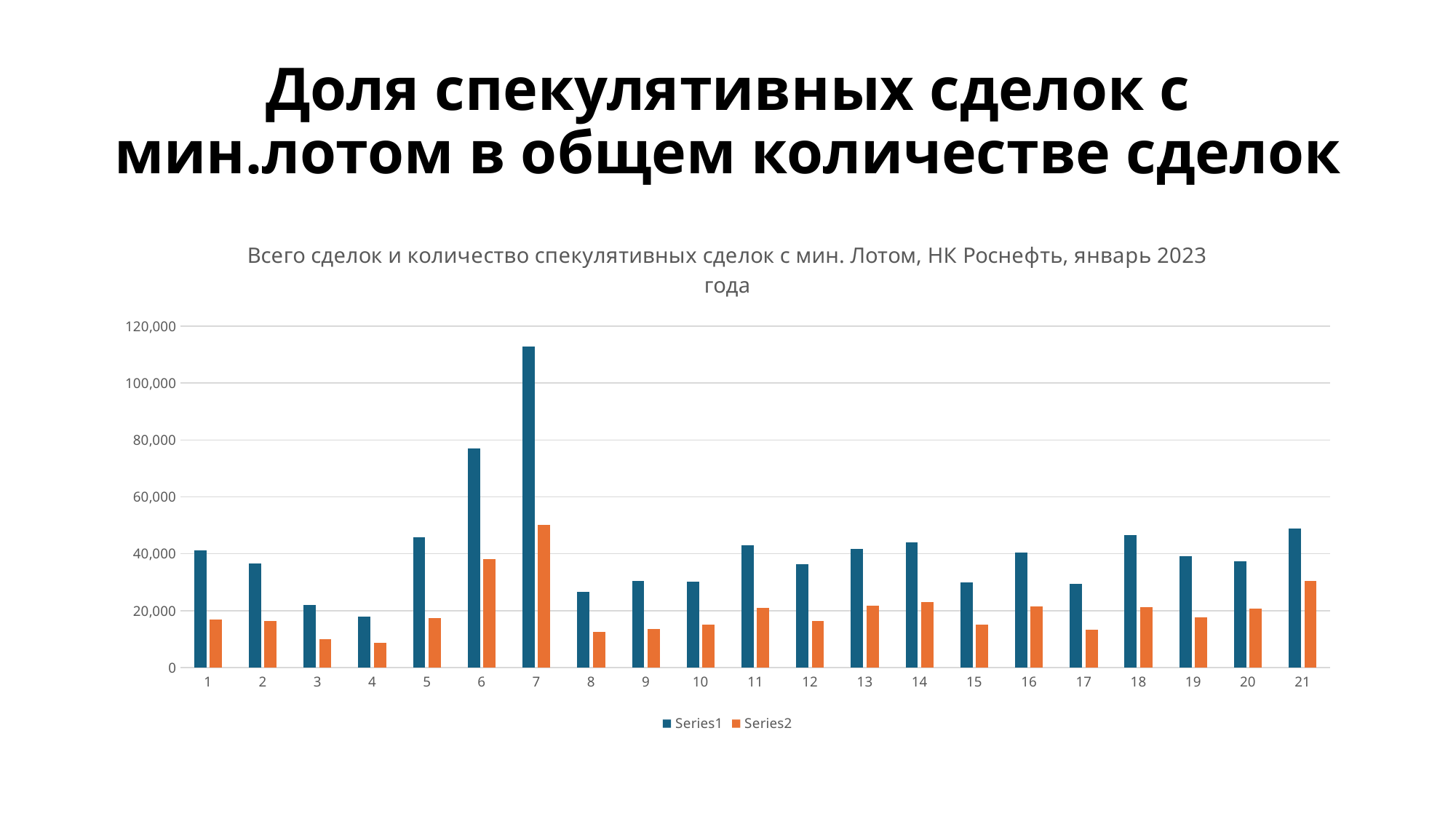
Is the Series1 value for category 7 greater or less than 100,000? greater How many series does the legend list? 2 Which is larger, the Series1 value for category 6 or for category 21? category 6 Is the Series2 value for category 7 greater or less than 40,000? greater Which category has the highest Series1 value? 7 Is the Series1 value for category 4 greater or less than 20,000? less What is the title of the chart? Всего сделок и количество спекулятивных сделок с мин. Лотом, НК Роснефть, январь 2023 года Which category has the highest Series2 value? 7 What kind of chart is shown on the slide? bar chart How many categories are shown on the x axis? 21 Which category has the lowest Series1 value? 4